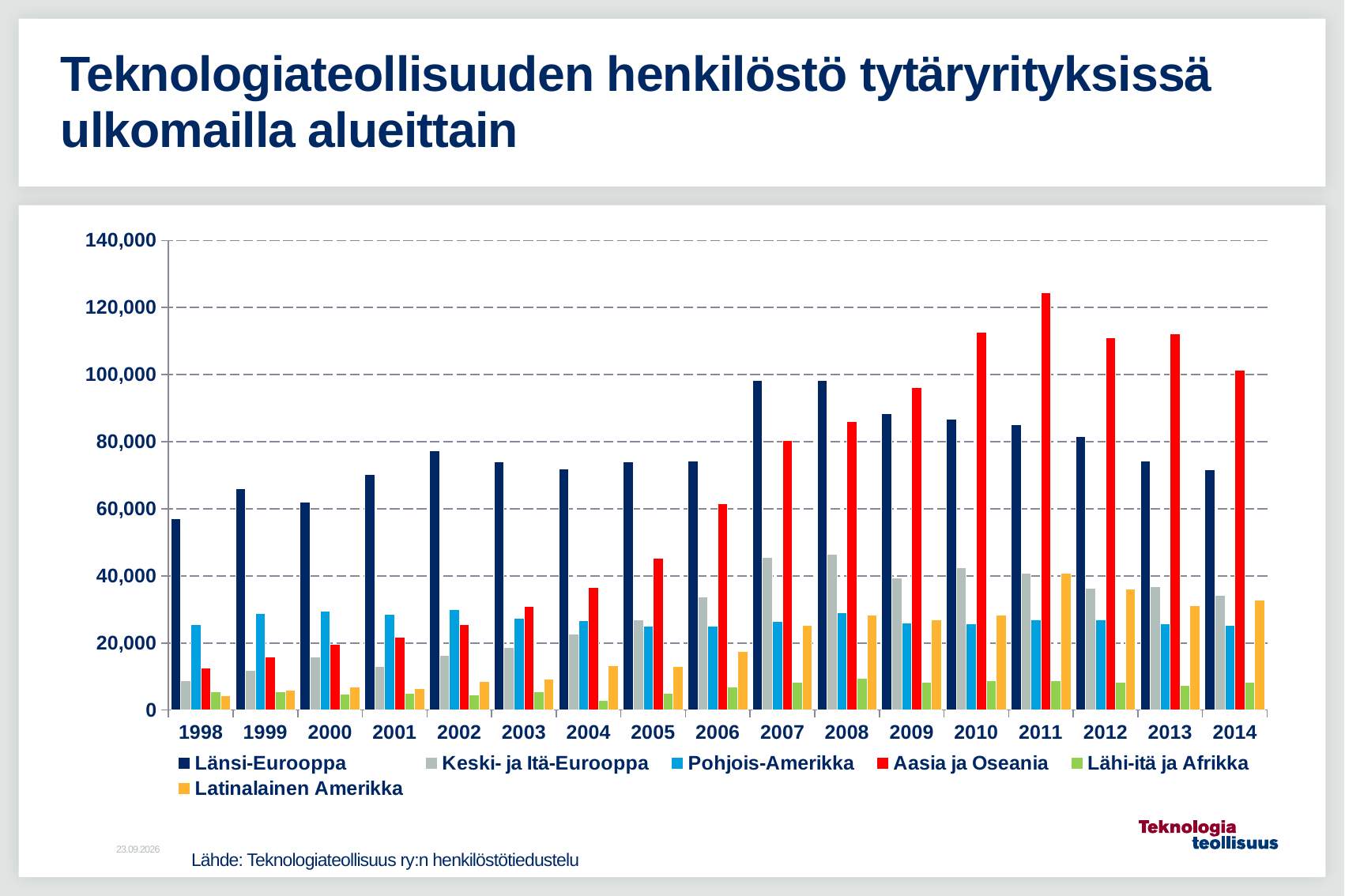
In which year is the value for Länsi-Eurooppa lowest? 1998 Is the value for Keski- ja Itä-Eurooppa in 2008 greater or less than 40,000? greater How many series does the legend list? 6 Does the value for Aasia ja Oseania rise or fall from 1998 to 2011? rise Is the value for Aasia ja Oseania in 2011 greater or less than 120,000? greater What colour are the bars for Aasia ja Oseania? red How many years are shown on the x axis? 17 Is the value for Länsi-Eurooppa in 1998 greater or less than 60,000? less Which is larger in 1998, Länsi-Eurooppa or Aasia ja Oseania? Länsi-Eurooppa In which year is the value for Aasia ja Oseania highest? 2011 Which is larger in 2014, Aasia ja Oseania or Länsi-Eurooppa? Aasia ja Oseania What kind of chart is shown on the slide? bar chart